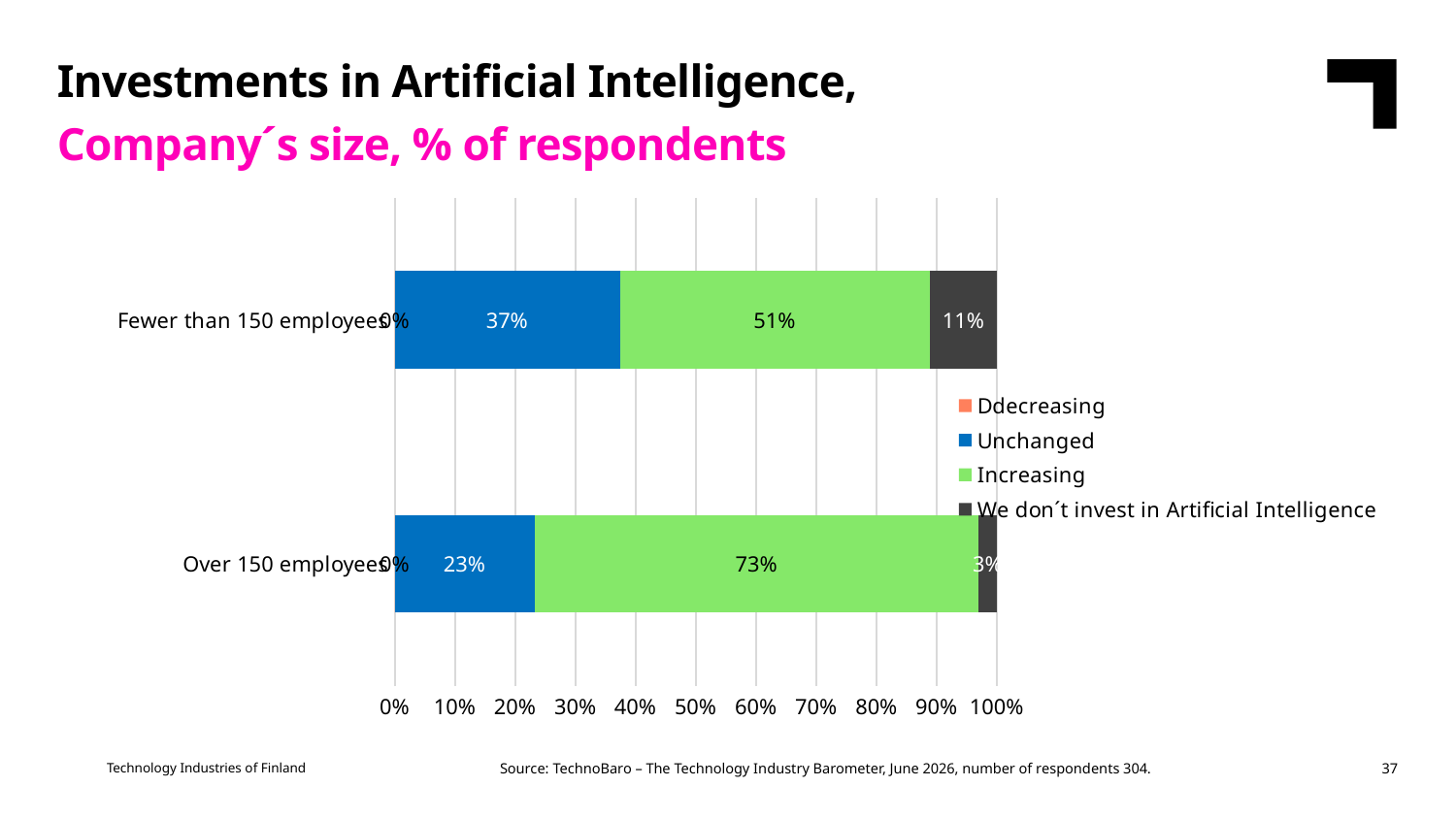
What type of chart is shown on the slide? Stacked bar chart What percentage of respondents from companies with fewer than 150 employees report increasing investments in AI? 51% What is the 'Ddecreasing' value for companies with fewer than 150 employees? 0% What is the 'Increasing' value for companies with over 150 employees? 73% How many company size categories are shown in the chart? 2 What is the difference in the 'Increasing' share between companies with over 150 employees and those with fewer than 150 employees? 22 percentage points Which response category has the largest share among companies with fewer than 150 employees? Increasing What is the 'Unchanged' value for companies with over 150 employees? 23% What is the difference in the 'Unchanged' share between companies with fewer than 150 employees and those with over 150 employees? 14 percentage points Which company size group has the larger share of respondents reporting increasing AI investments? Over 150 employees What share of companies with fewer than 150 employees say they don't invest in Artificial Intelligence? 11% How many series does the legend list? 4